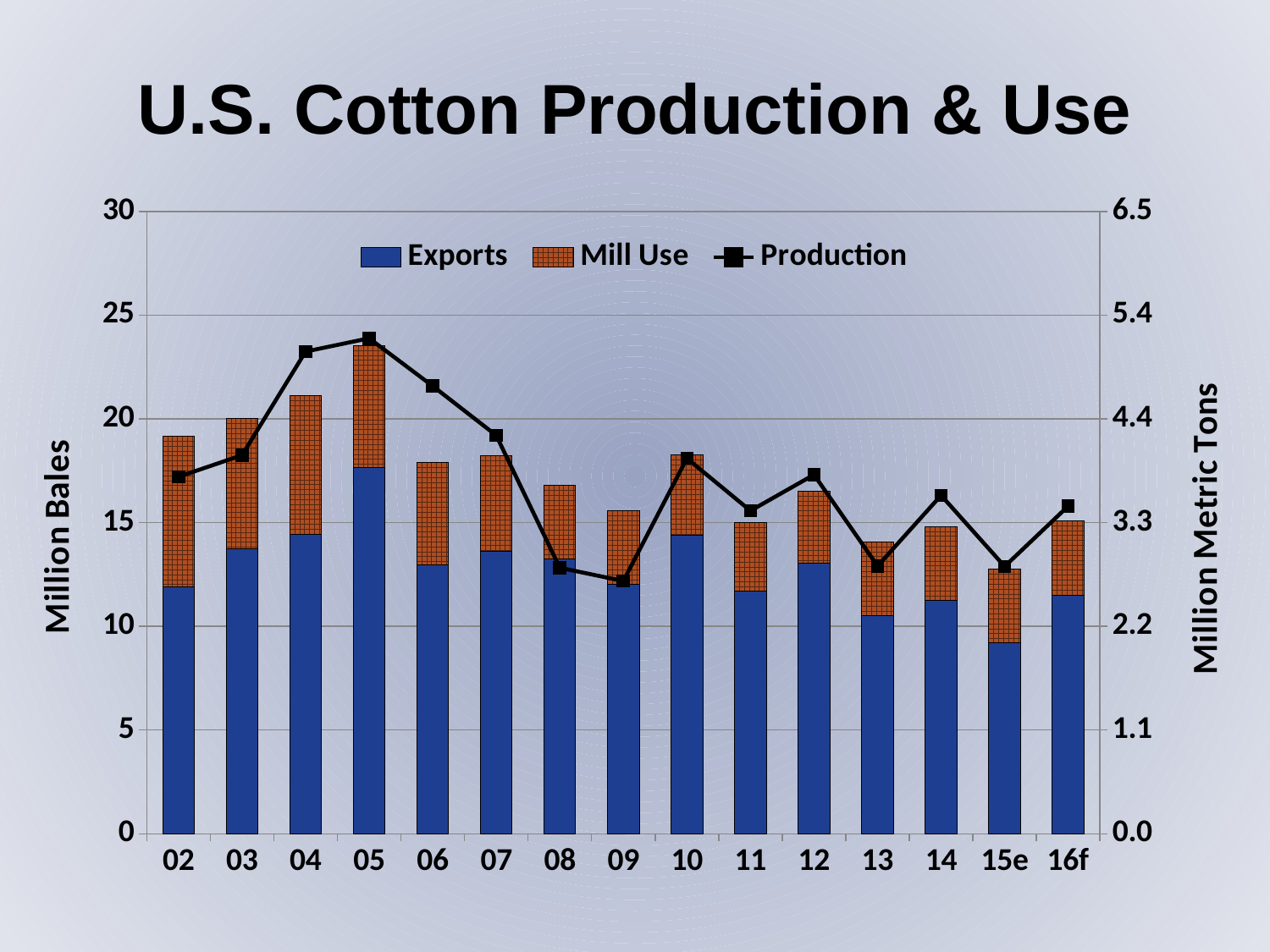
What is the title of the chart? U.S. Cotton Production & Use Which year has the shortest stacked bar (Exports plus Mill Use)? 15e How many years are shown on the x axis? 15 Is the Exports value for 05 greater or less than 15 million bales? greater Which year has the tallest stacked bar (Exports plus Mill Use)? 05 What kind of chart is this? Stacked bar chart with a line Which year has the larger Exports value, 05 or 15e? 05 Is the Exports value for 15e greater or less than 10 million bales? less How many series does the legend list? 3 In which year does the Production line reach its lowest point? 09 Is the Production value for 04 greater or less than 4.4 million metric tons? greater Does the Production line rise or fall from 05 to 09? fall